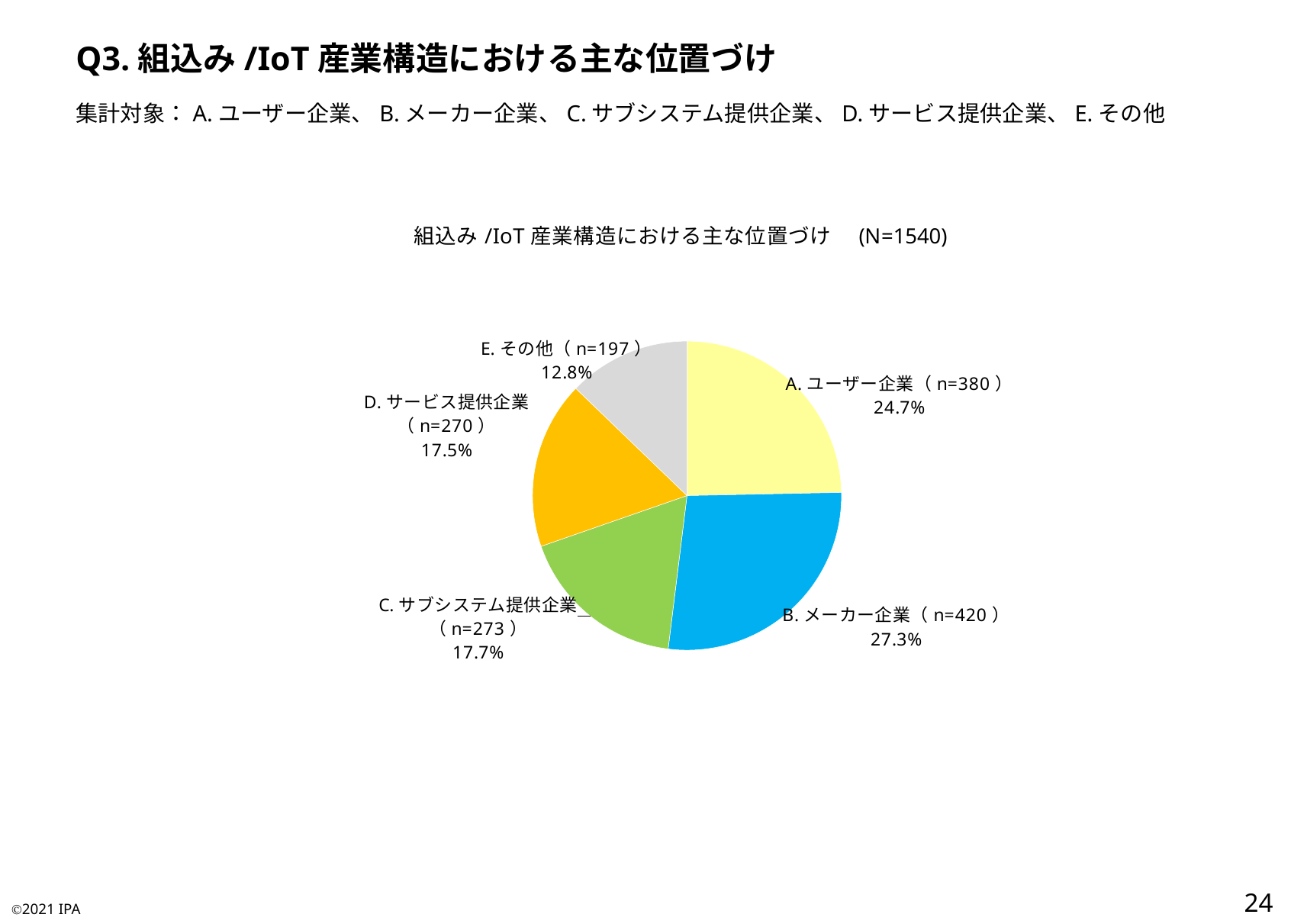
What is the total N shown in the chart title? 1540 Which category has the smallest share of the pie? E. その他 What percentage share does B. メーカー企業 have? 27.3% What is the difference in percentage points between A. ユーザー企業 and E. その他? 11.9 How many categories are shown in the pie chart? 5 What percentage share does E. その他 have? 12.8% What kind of chart is shown on the slide? pie chart What colour is the slice for C. サブシステム提供企業? green Which has a larger share, A. ユーザー企業 or D. サービス提供企業? A. ユーザー企業 Which category has the largest share of the pie? B. メーカー企業 What is the difference in n between B. メーカー企業 and A. ユーザー企業? 40 What is the n value for D. サービス提供企業? 270